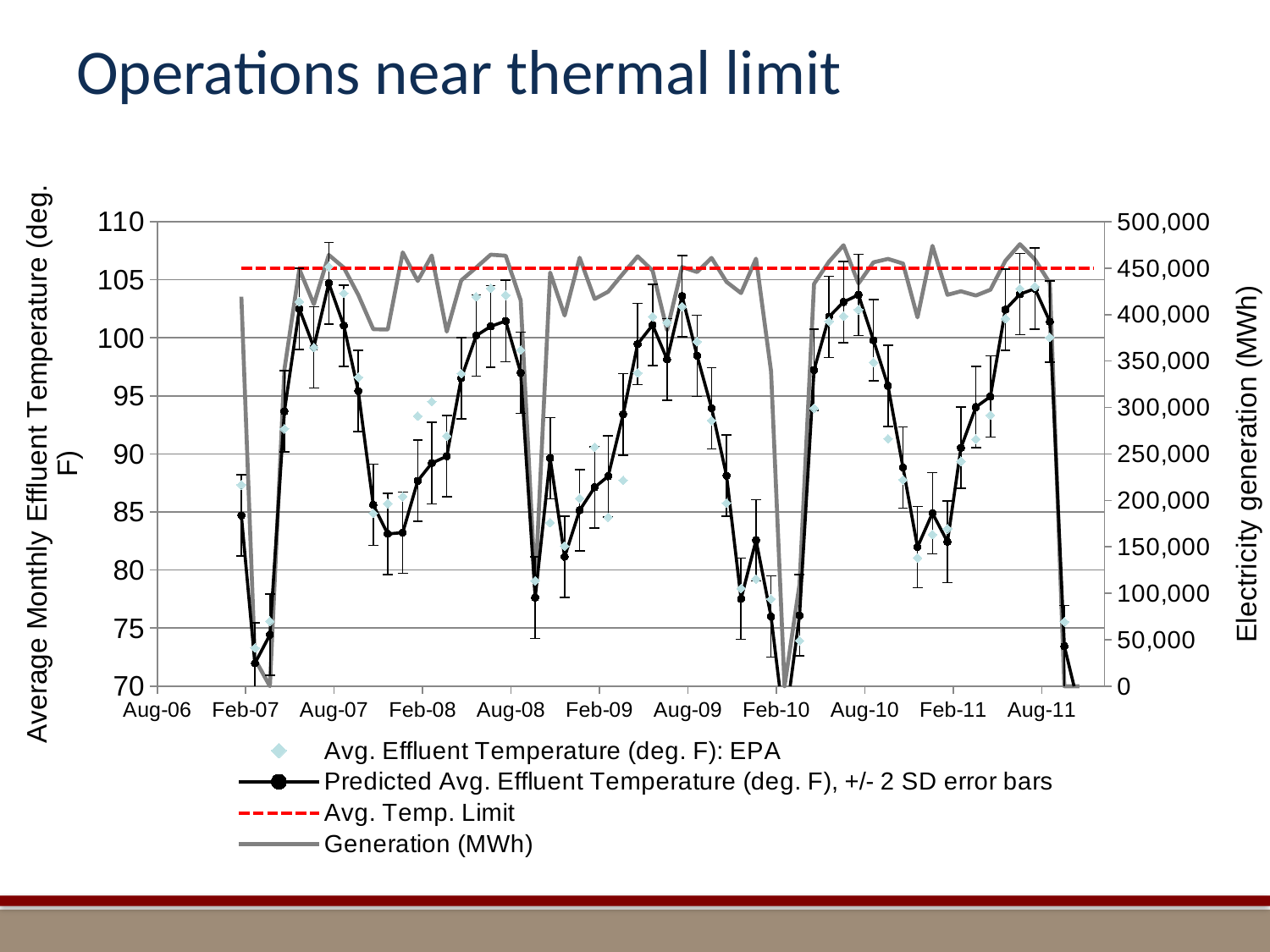
Is the Avg. Temp. Limit line greater or less than 105 on the left axis? greater Is the Generation (MWh) value at Aug-07 greater or less than 400,000? greater Is the Predicted Avg. Effluent Temperature at Feb-08 greater or less than 90? less What is the title of the slide containing the chart? Operations near thermal limit Which is larger, the Predicted Avg. Effluent Temperature at Aug-07 or at Feb-08? Aug-07 How many series does the legend list? 4 What is the label of the right-hand vertical axis? Electricity generation (MWh) How many date labels are shown along the x axis? 11 What kind of chart is shown on the slide? line chart